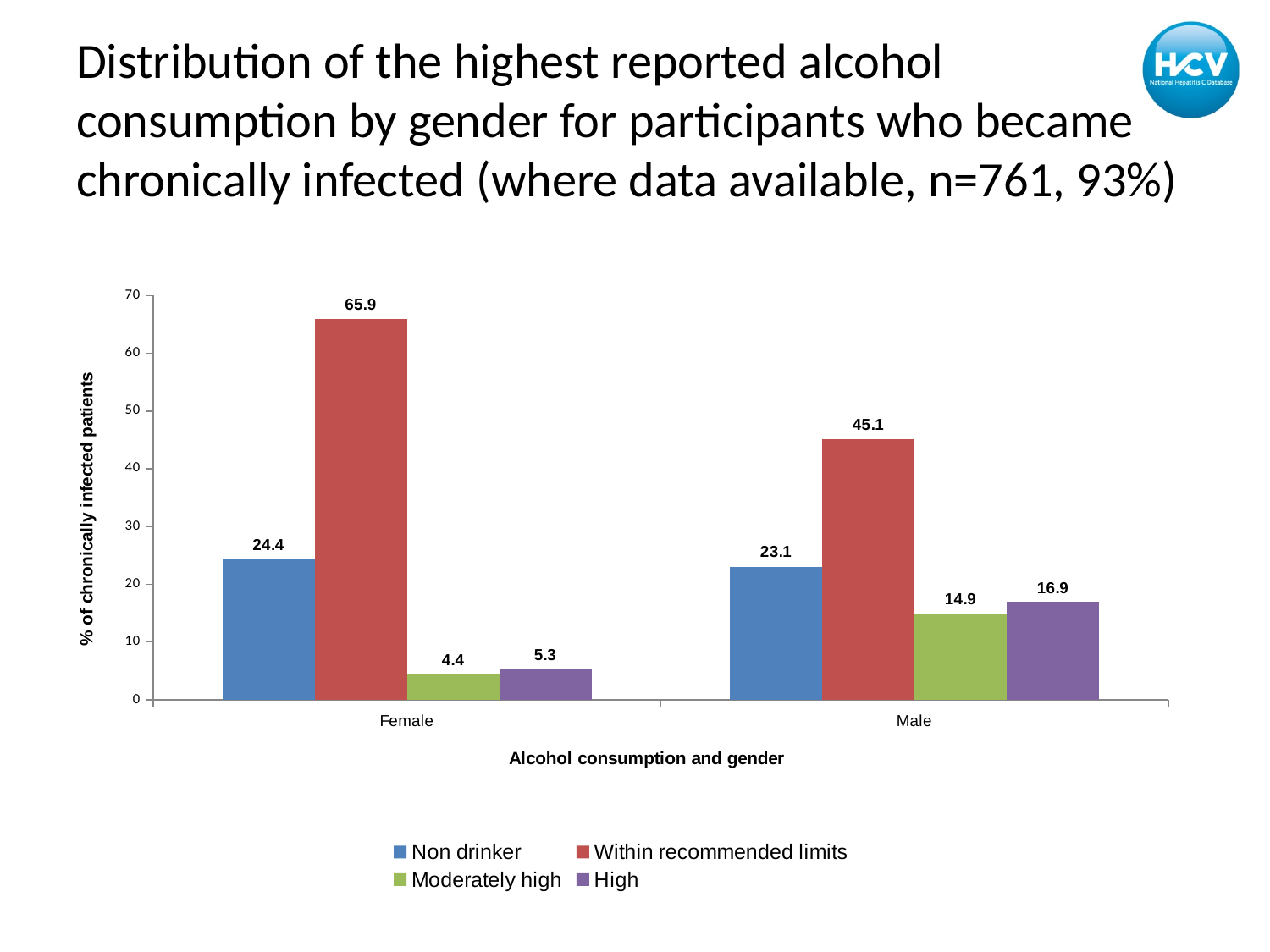
What is the difference between the Within recommended limits values for Female and Male? 20.8 Which alcohol consumption category has the highest value for Male? Within recommended limits What is the value for Within recommended limits for Female? 65.9 What is the value for High for Female? 5.3 Which is larger, the Non drinker value for Female or for Male? Female What kind of chart is shown on the slide? Bar chart How many gender categories are shown on the x axis? 2 What is the value for Non drinker for Male? 23.1 Which alcohol consumption category has the lowest value for Female? Moderately high How many series does the legend list? 4 What is the label of the y axis? % of chronically infected patients What is the value for Moderately high for Male? 14.9